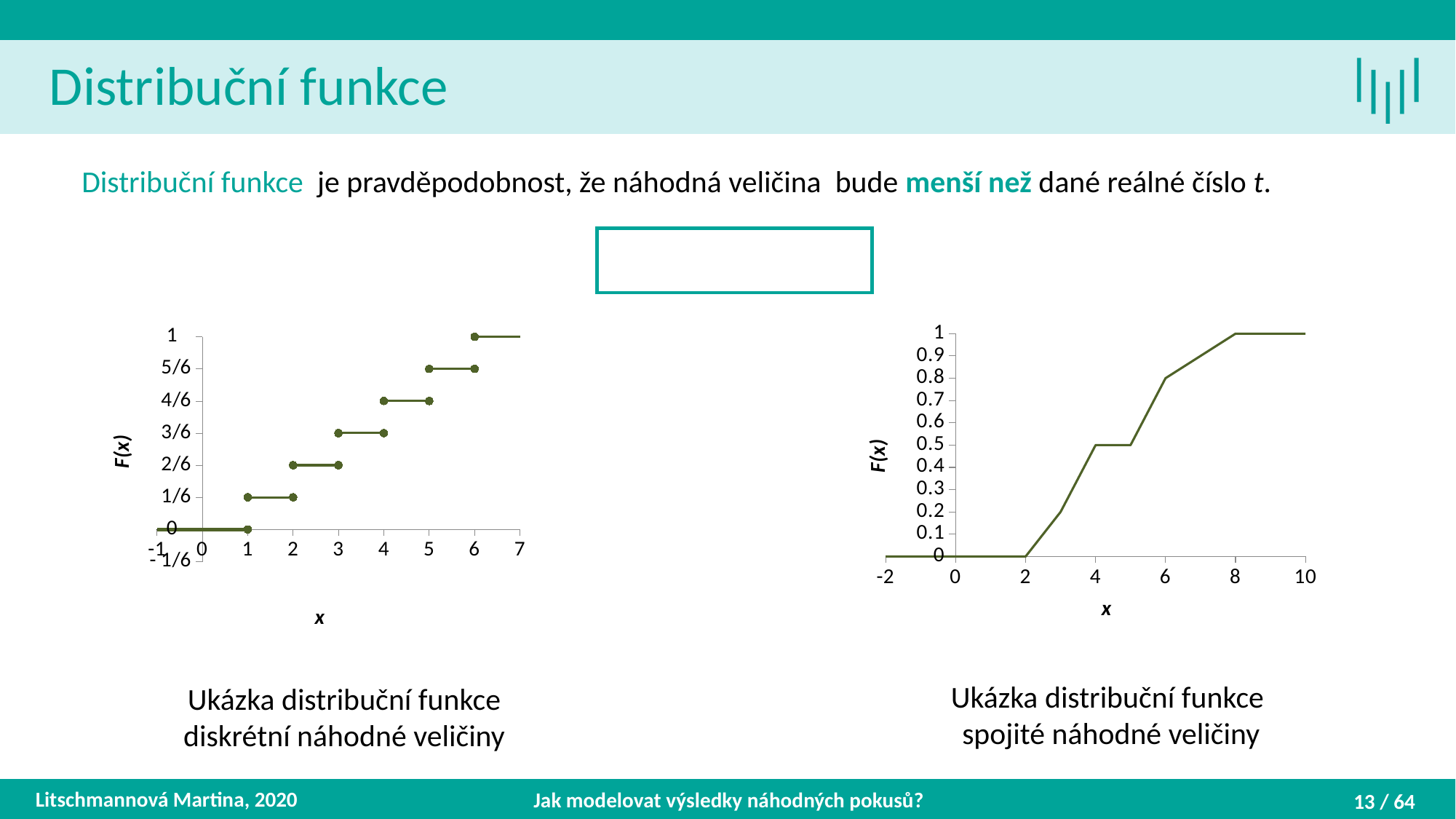
In the left chart (discrete distribution function), do the values rise or fall as x increases? rise In the right chart (continuous distribution function), is the value of F(x) at x = 3 greater or less than 0.5? less In the right chart (continuous distribution function), what is the value of F(x) at x = 2? 0 What is the label of the vertical axis in the left chart? F(x) In the right chart (continuous distribution function), is the value of F(x) at x = 6 greater or less than 0.5? greater In the right chart (continuous distribution function), what is the value of F(x) at x = 4? 0.5 In the right chart (continuous distribution function), what is the value of F(x) at x = 8? 1 In the left chart (discrete distribution function), which is larger: F(x) at x = 2 or at x = 5? x = 5 What kind of chart is the left chart (Ukázka distribuční funkce diskrétní náhodné veličiny)? line chart